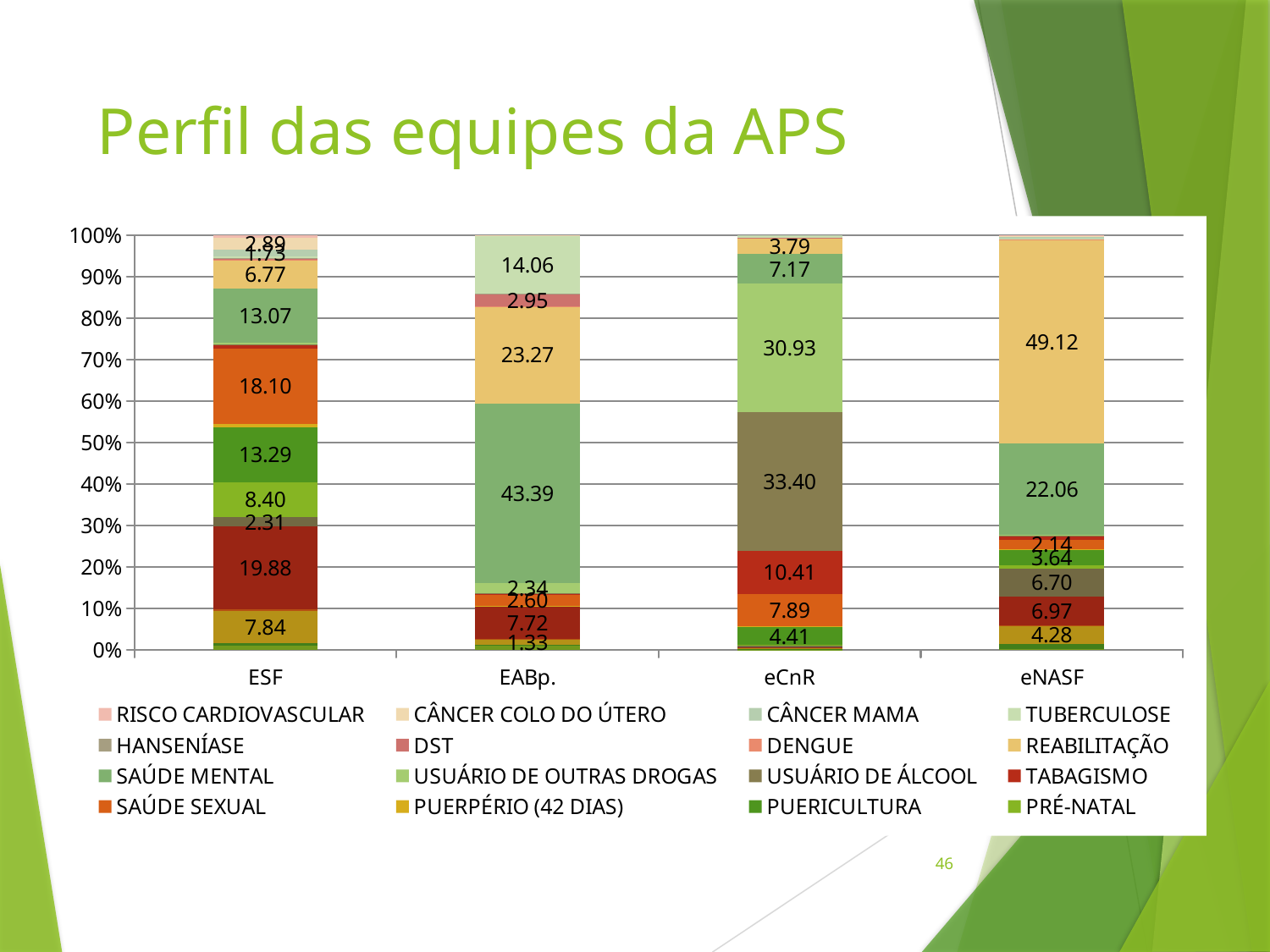
What is the value of the largest segment in the ESF bar? 19.88 What is the value of the largest segment in the eNASF bar? 49.12 What is the value of the largest segment in the eCnR bar? 33.40 What kind of chart is shown on the slide? stacked bar chart What is the value for USUÁRIO DE ÁLCOOL in the eCnR bar? 33.40 What is the value of the largest segment in the EABp. bar? 43.39 How many categories (team types) are shown on the x axis? 4 Which is larger: the largest segment in the eNASF bar or the largest segment in the EABp. bar? eNASF (49.12) What is the value for REABILITAÇÃO in the eNASF bar? 49.12 What is the difference between the two largest segments in the eCnR bar (33.40 and 30.93)? 2.47 What is the title of the slide? Perfil das equipes da APS How many series does the legend list? 16